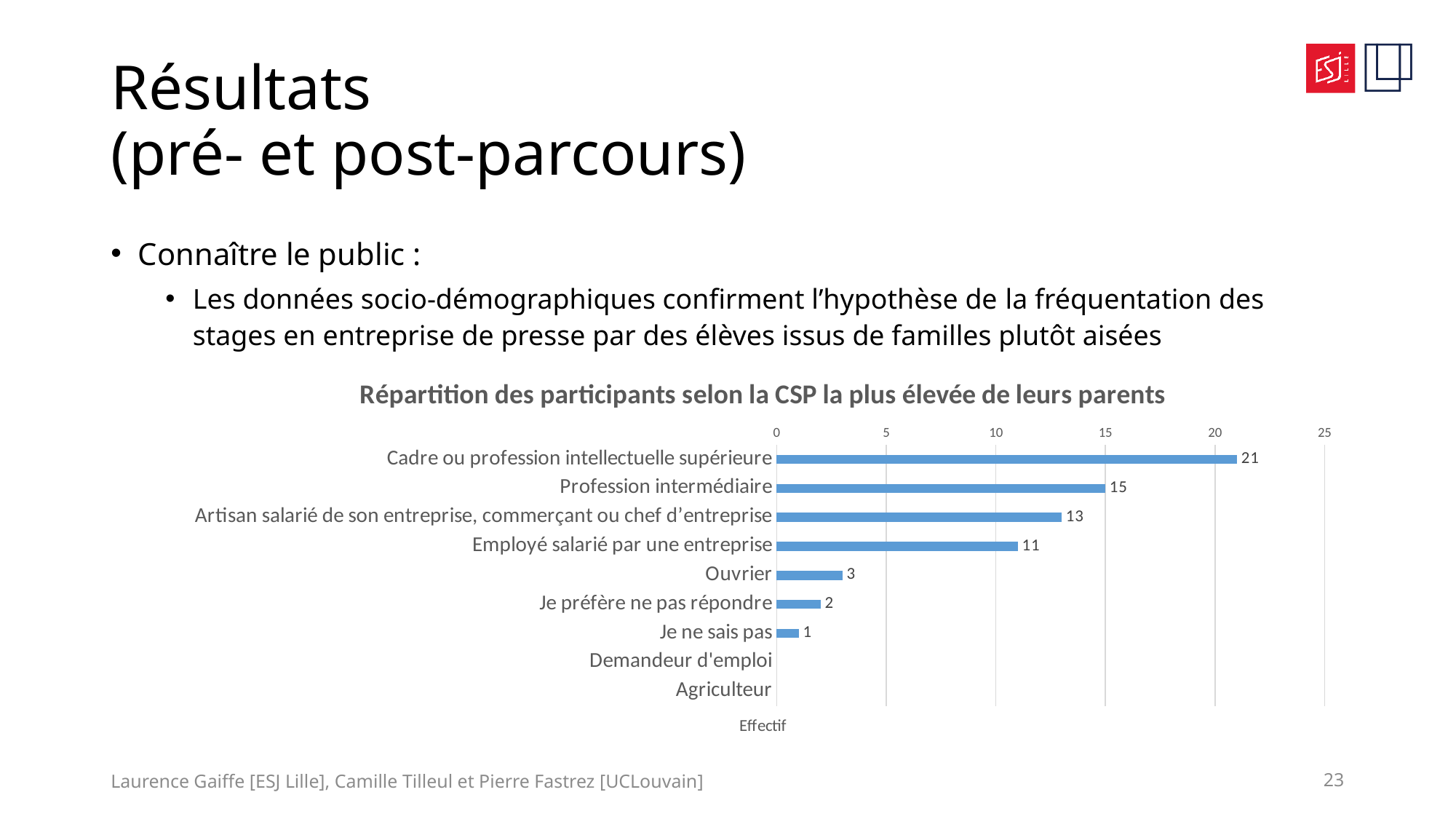
How many categories are listed on the chart? 9 Which category has the highest value? Cadre ou profession intellectuelle supérieure What type of chart is shown on the slide? Bar chart What is the difference between the values for "Cadre ou profession intellectuelle supérieure" and "Profession intermédiaire"? 6 What is the value for "Employé salarié par une entreprise"? 11 Which is larger, the value for "Artisan salarié de son entreprise, commerçant ou chef d'entreprise" or the value for "Employé salarié par une entreprise"? Artisan salarié de son entreprise, commerçant ou chef d'entreprise What is the title of the chart? Répartition des participants selon la CSP la plus élevée de leurs parents Is the value for "Profession intermédiaire" greater or less than 10? greater What is the value for "Ouvrier"? 3 What is the value for "Profession intermédiaire"? 15 What is the value for "Cadre ou profession intellectuelle supérieure"? 21